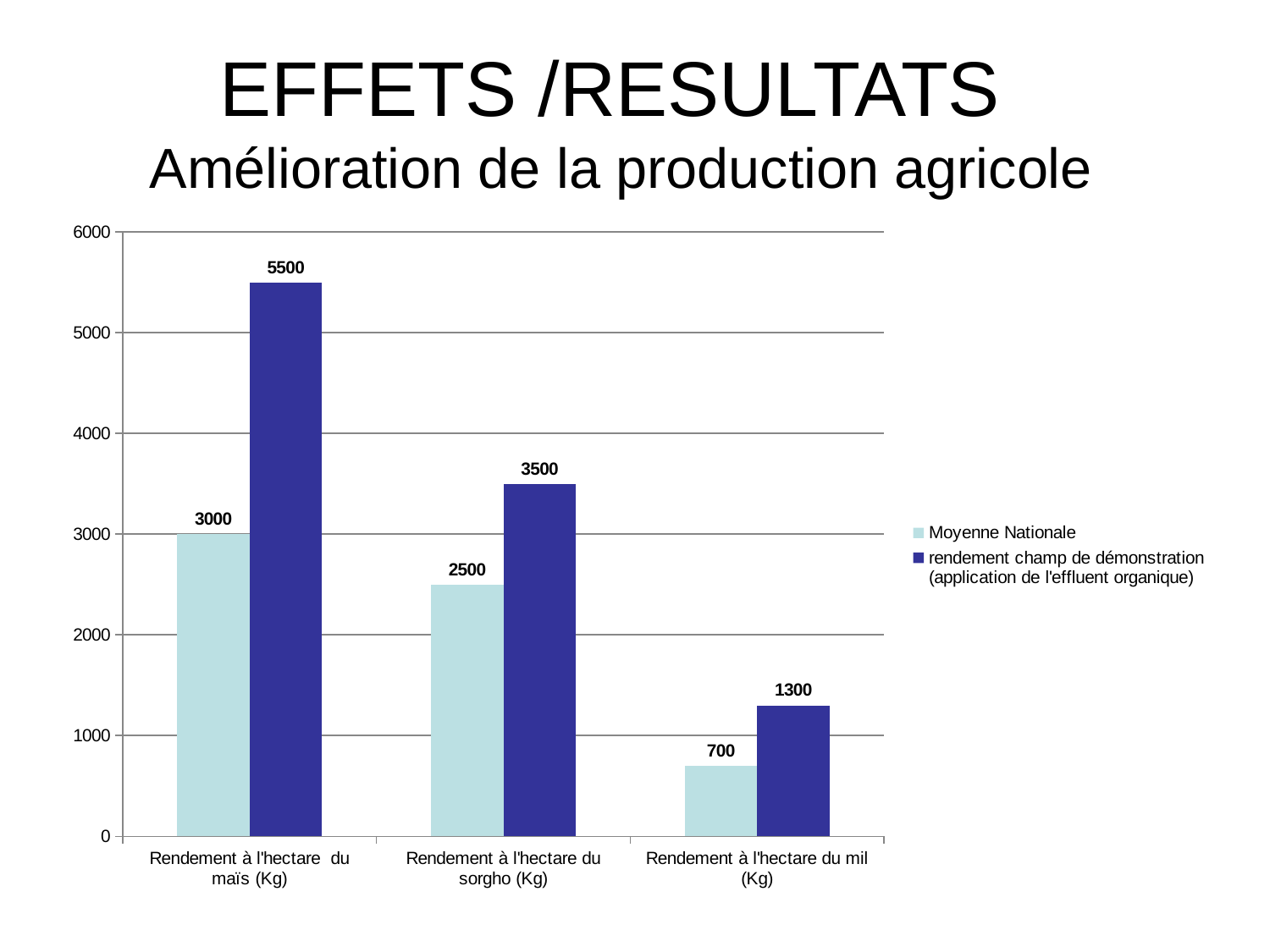
Which is larger: the Moyenne Nationale value for sorgho or the rendement champ de démonstration value for mil? Moyenne Nationale value for sorgho What kind of chart is shown on the slide? Bar chart What is the Moyenne Nationale value for Rendement à l'hectare du maïs (Kg)? 3000 Which category has the highest rendement champ de démonstration value? Rendement à l'hectare du maïs (Kg) Which category has the lowest Moyenne Nationale value? Rendement à l'hectare du mil (Kg) How many categories are shown on the x axis? 3 What is the difference between the rendement champ de démonstration and Moyenne Nationale values for Rendement à l'hectare du maïs (Kg)? 2500 What is the difference between the rendement champ de démonstration and Moyenne Nationale values for Rendement à l'hectare du mil (Kg)? 600 How many series does the legend list? 2 What is the Moyenne Nationale value for Rendement à l'hectare du mil (Kg)? 700 Is the rendement champ de démonstration value for Rendement à l'hectare du sorgho (Kg) greater or less than 3000? greater What is the rendement champ de démonstration value for Rendement à l'hectare du sorgho (Kg)? 3500